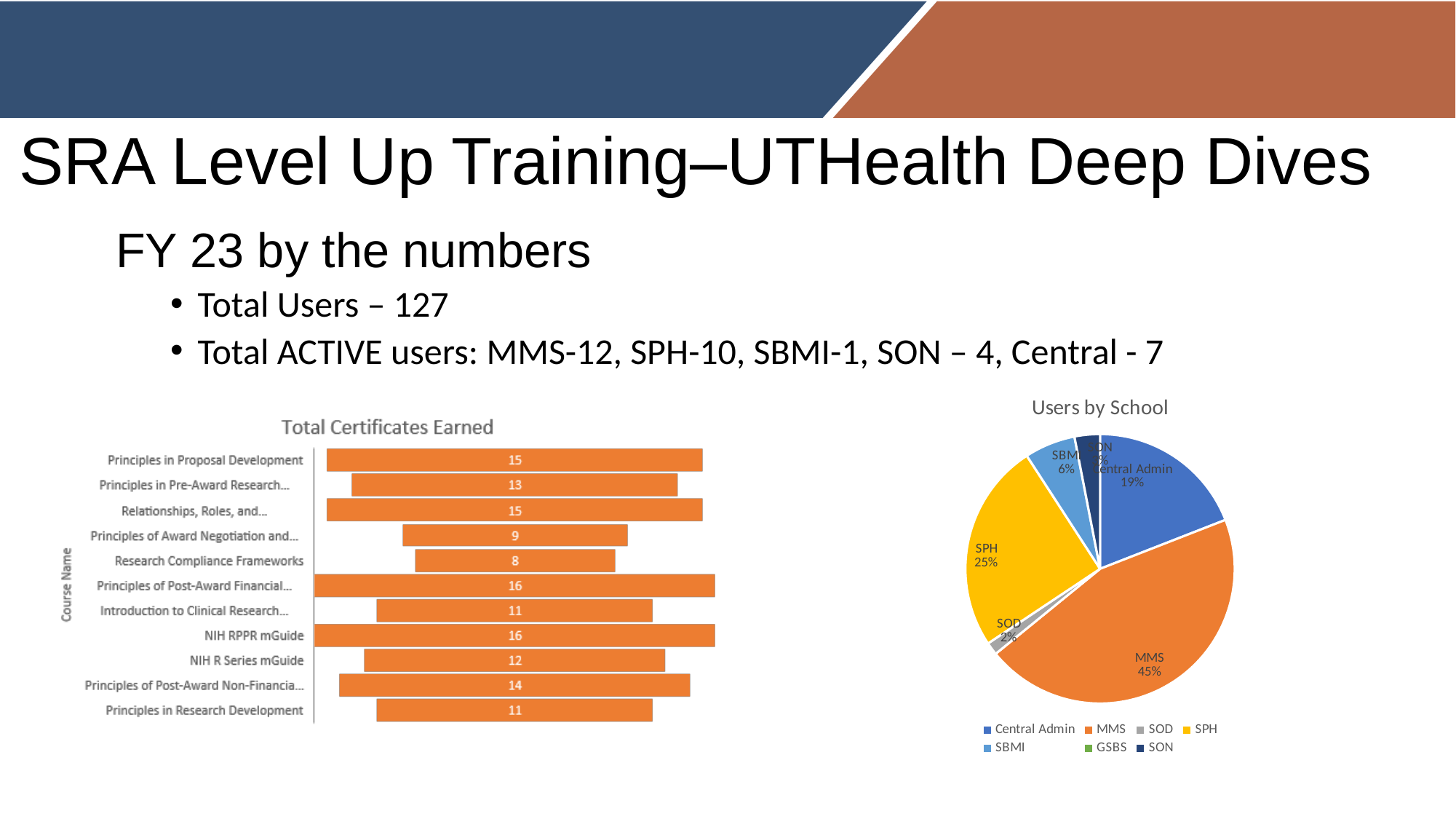
In the Users by School pie chart, which school has the largest share of users? MMS In the Total Certificates Earned chart, which course has the lowest number of certificates earned? Research Compliance Frameworks In the Total Certificates Earned chart, which is larger: Principles in Proposal Development or Research Compliance Frameworks? Principles in Proposal Development How many entries does the legend of the Users by School pie chart list? 7 In the Total Certificates Earned chart, what is the value for NIH R Series mGuide? 12 In the Total Certificates Earned chart, what is the value for Principles in Proposal Development? 15 In the Users by School pie chart, what share of users is SPH? 25% In the Users by School pie chart, what share of users is MMS? 45% How many courses are shown in the Total Certificates Earned chart? 11 In the Total Certificates Earned chart, how many certificates were earned for Research Compliance Frameworks? 8 What type of chart is the Total Certificates Earned chart? Bar chart In the Total Certificates Earned chart, what is the difference between NIH RPPR mGuide and Principles in Research Development? 5